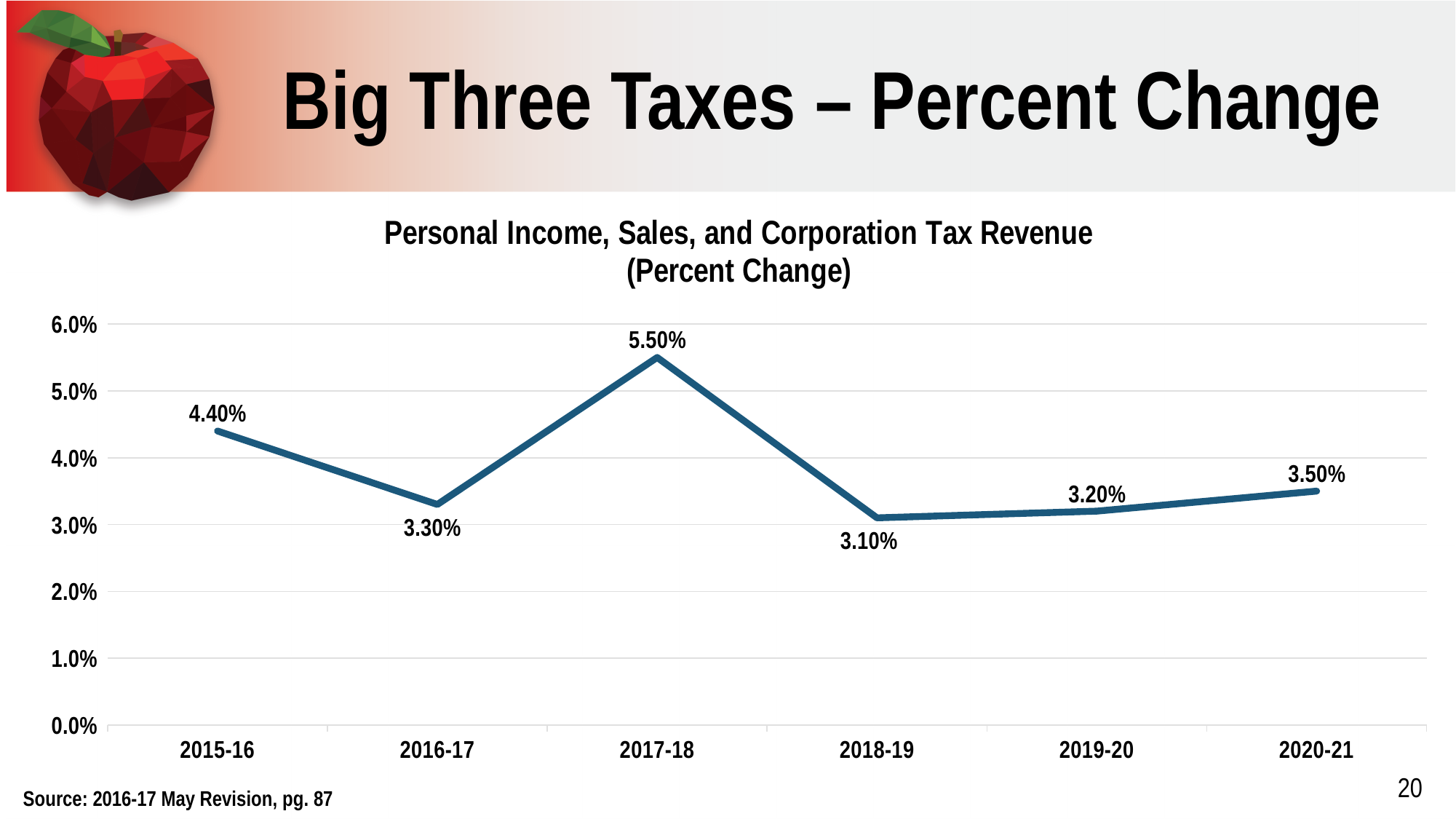
What is the difference between the percent change in 2015-16 and 2016-17? 1.10% Which fiscal year has the highest percent change? 2017-18 Do the values rise or fall from 2018-19 to 2020-21? rise How many fiscal years are plotted on the chart? 6 Which fiscal year has the lowest percent change? 2018-19 What kind of chart is shown on the slide? line chart What is the percent change for 2020-21? 3.50% Is the value for 2017-18 greater or less than 5.0%? greater Which is larger, the percent change for 2019-20 or for 2020-21? 2020-21 What is the difference between the percent change in 2017-18 and 2018-19? 2.40% What is the percent change for 2015-16? 4.40% What is the percent change for 2017-18? 5.50%